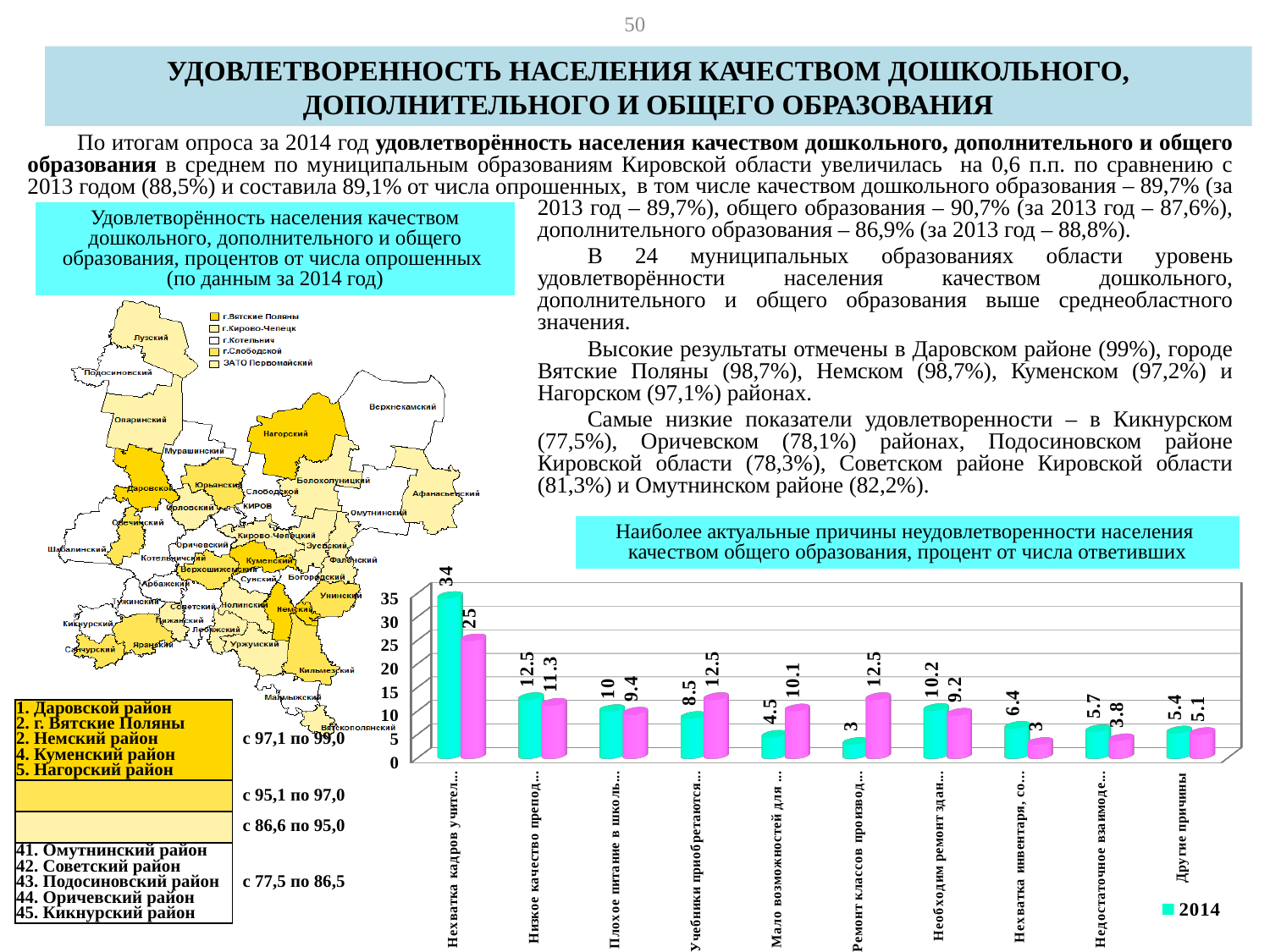
In the bar chart on the causes of dissatisfaction, what is the 2014 (cyan) value for the first category, 'Нехватка кадров учител...'? 34 In the bar chart on the causes of dissatisfaction with general education, how many categories are shown along the x axis? 10 In the bar chart on the causes of dissatisfaction, which category has the highest 2014 (cyan) value? Нехватка кадров учител... In the bar chart on the causes of dissatisfaction, what is the difference between the cyan and magenta values for 'Нехватка инвентаря, со...'? 3.4 In the bar chart on the causes of dissatisfaction, what is the magenta (second series) value for 'Ремонт классов производ...'? 12.5 In the bar chart on the causes of dissatisfaction, what is the 2014 (cyan) value for 'Другие причины'? 5.4 In the bar chart on the causes of dissatisfaction, what is the difference between the cyan and magenta values for 'Нехватка кадров учител...'? 9 Which year is named in the legend of the bar chart on the causes of dissatisfaction? 2014 What kind of chart is shown at the bottom right of the slide, under the title 'Наиболее актуальные причины неудовлетворенности населения качеством общего образования'? bar chart In the bar chart on the causes of dissatisfaction, which is larger for 'Мало возможностей для ...': the cyan 2014 bar or the magenta bar? the magenta bar In the bar chart on the causes of dissatisfaction, is the 2014 (cyan) value for 'Низкое качество препод...' greater or less than 10? greater In the bar chart on the causes of dissatisfaction, which category has the lowest 2014 (cyan) value? Ремонт классов производ...